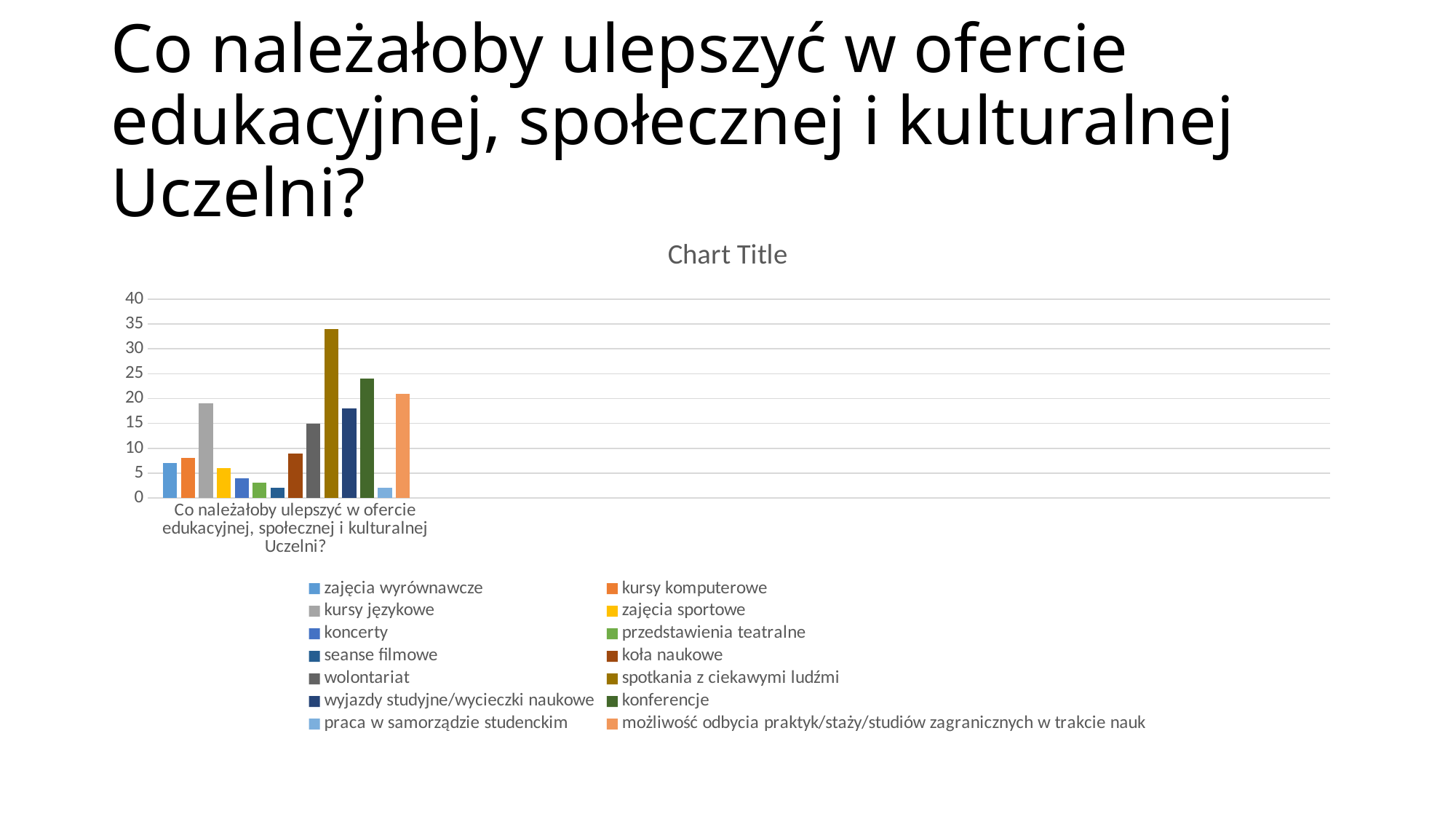
Is the value for koncerty greater or less than 5? less How many series does the chart legend list? 14 Which series has the highest value in the chart? spotkania z ciekawymi ludźmi Is the value for spotkania z ciekawymi ludźmi greater or less than 30? greater What is the title shown above the chart? Chart Title Is the value for konferencje greater or less than 20? greater Which is larger, the value for wolontariat or the value for zajęcia sportowe? wolontariat Which is larger, the value for kursy językowe or the value for koła naukowe? kursy językowe What kind of chart is shown on the slide? bar chart Which is larger, the value for konferencje or the value for wyjazdy studyjne/wycieczki naukowe? konferencje